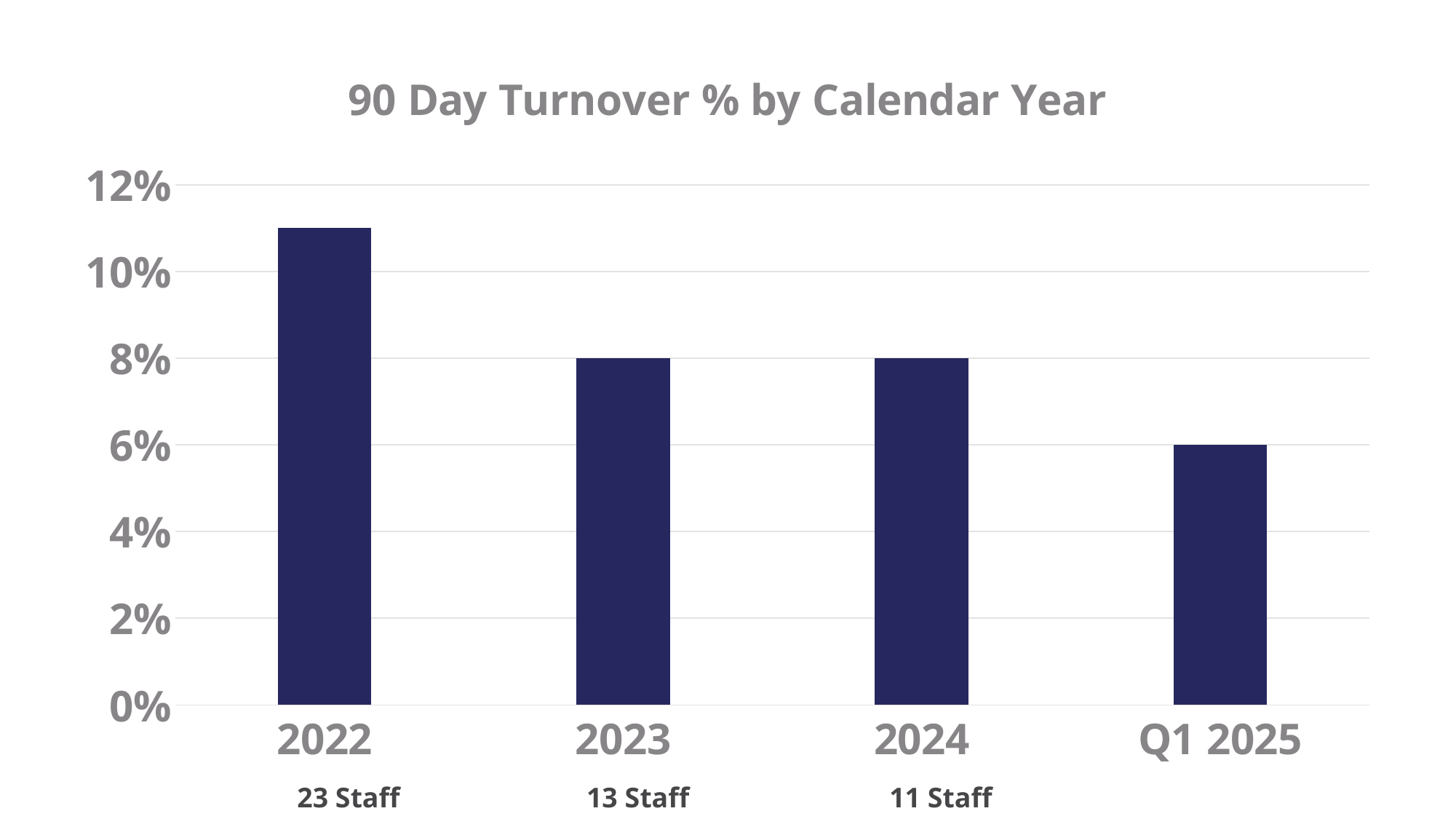
Which period has the highest 90 Day Turnover %? 2022 Does the 90 Day Turnover % generally rise or fall from 2022 to Q1 2025? fall How many staff are noted under the 2022 bar? 23 Staff What kind of chart is this? bar chart Is the 90 Day Turnover % for 2022 greater or less than 10%? greater Which has a higher 90 Day Turnover %, 2022 or Q1 2025? 2022 What is the difference between the 90 Day Turnover % for 2023 and Q1 2025? 2% What is the 90 Day Turnover % for 2024? 8% Which period has the lowest 90 Day Turnover %? Q1 2025 How many periods are shown on the x axis? 4 What is the 90 Day Turnover % for Q1 2025? 6% What is the 90 Day Turnover % for 2023? 8%